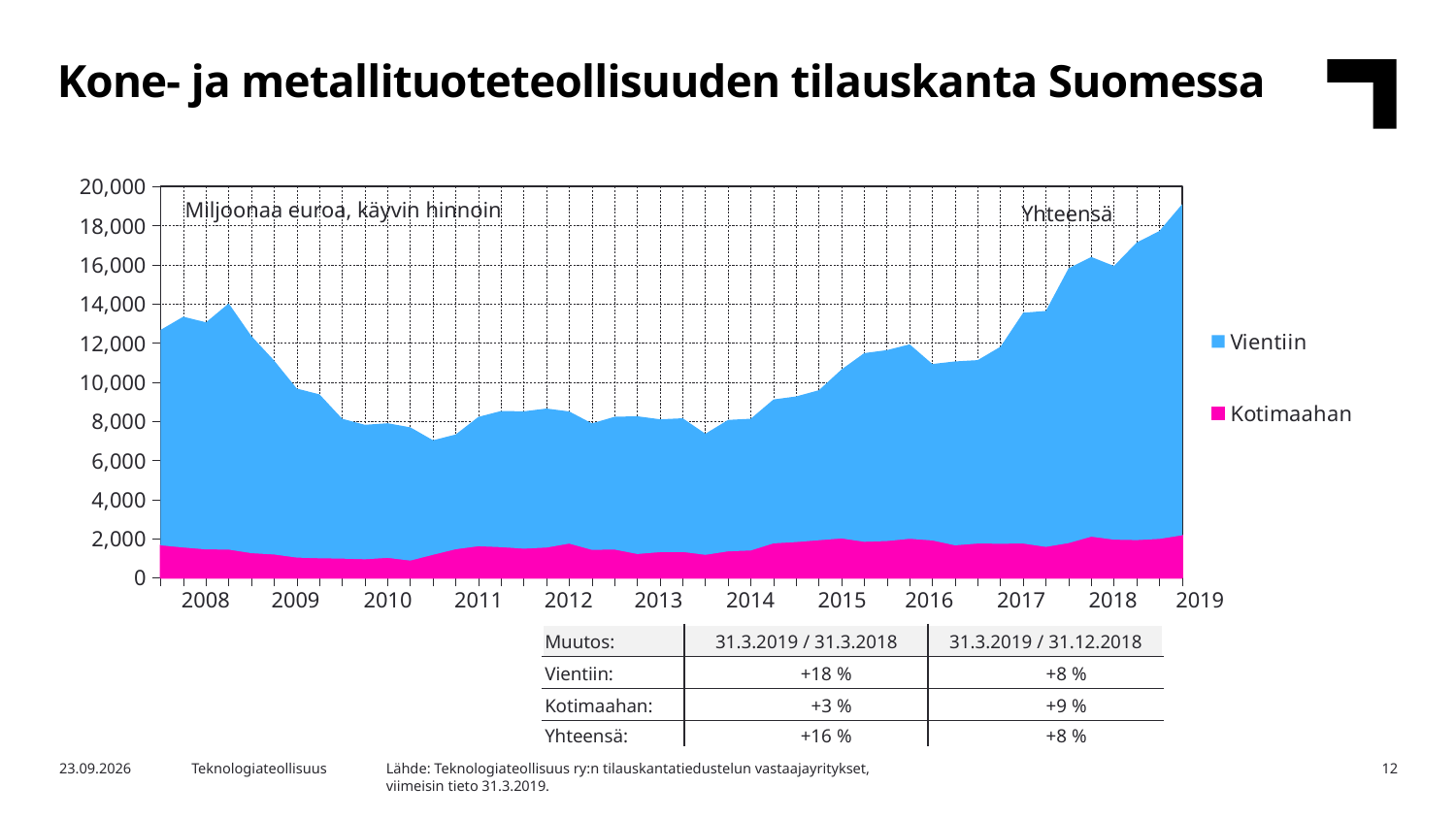
Is the total (Yhteensä) value at the start of 2013 greater or less than 10,000? less What kind of chart is shown on the slide? Stacked area chart Is the total (Yhteensä) value at the start of 2008 greater or less than 12,000? greater Is the Kotimaahan value at the start of 2008 greater or less than 2,000? less Which two series are listed in the chart legend? Vientiin and Kotimaahan How many series does the chart legend list? 2 How many year labels are shown on the x axis? 12 Does the total order backlog rise or fall between 2016 and 2019? rise In which year shown on the x axis does the total (Yhteensä) reach its highest level? 2019 What unit is stated in the chart's annotation? Miljoonaa euroa, käyvin hinnoin